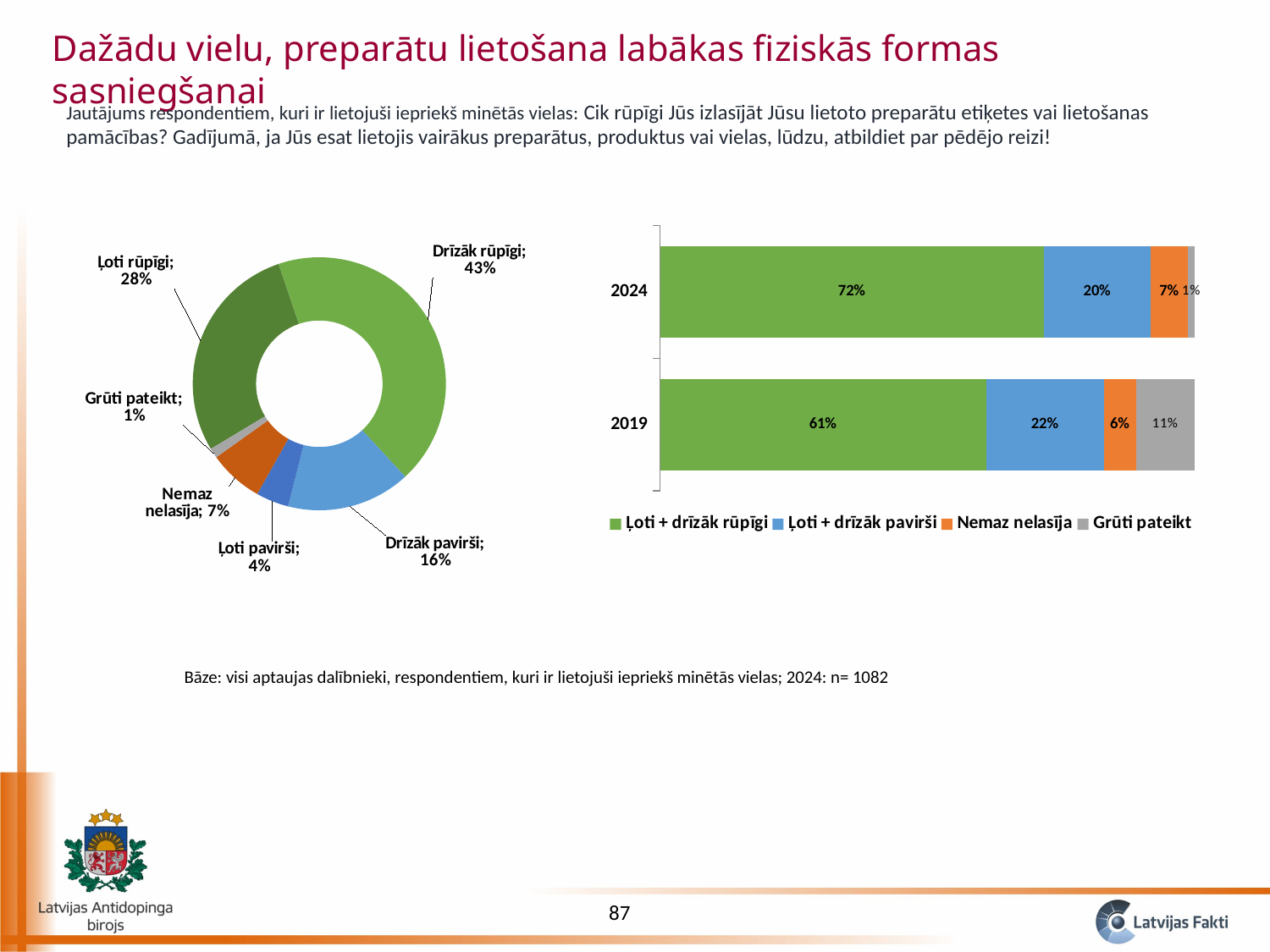
In the doughnut chart on the left, what share is labelled for "Drīzāk rūpīgi"? 43% In the doughnut chart on the left, what share is labelled for "Ļoti rūpīgi"? 28% In the doughnut chart on the left, which category has the smallest share? Grūti pateikt In the doughnut chart on the left, which category has the largest share? Drīzāk rūpīgi In the stacked bar chart on the right, how many series does the legend list? 4 In the stacked bar chart on the right, what is the difference between the "Ļoti + drīzāk rūpīgi" values for 2024 and 2019? 11% In the stacked bar chart on the right, what is the value for "Ļoti + drīzāk rūpīgi" in 2024? 72% In the stacked bar chart on the right, which year has the larger value for "Ļoti + drīzāk rūpīgi", 2019 or 2024? 2024 In the doughnut chart on the left, what is the difference between the shares for "Drīzāk pavirši" and "Ļoti pavirši"? 12% What type of chart is shown on the right side of the slide? Stacked bar chart In the stacked bar chart on the right, what is the value for "Grūti pateikt" in 2019? 11% In the doughnut chart on the left, how many categories are shown? 6